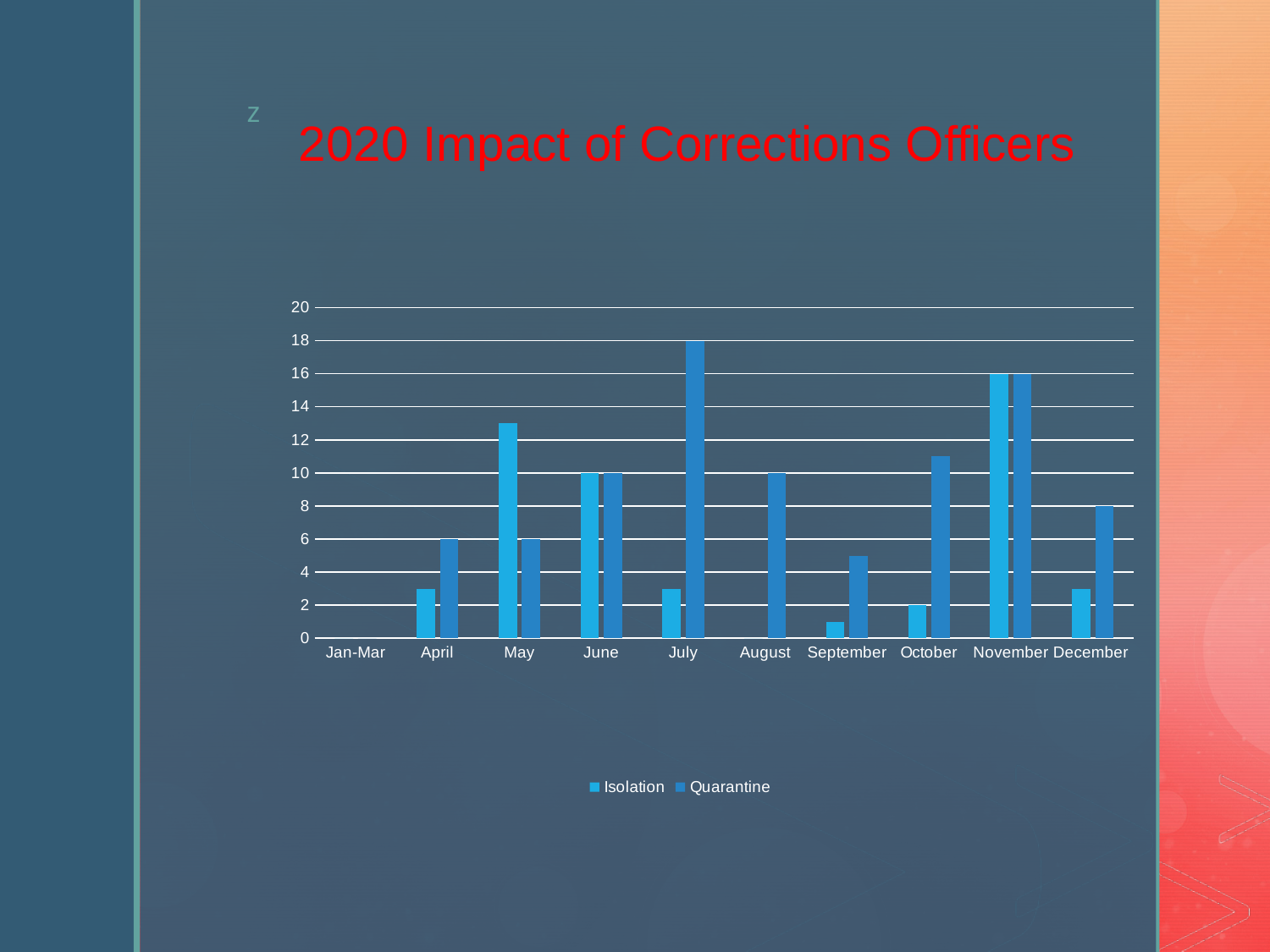
Which is larger in May, Isolation or Quarantine? Isolation What is the Isolation value for November? 16 How many series does the legend list? 2 What type of chart is shown on the slide? bar chart Is the Quarantine value for September greater or less than 6? less Is the Isolation value for May greater or less than 12? greater Which category has the highest Quarantine value? July What is the title of the chart? 2020 Impact of Corrections Officers How many categories are shown on the x axis? 10 Which category has the highest Isolation value? November Which is larger in October, Isolation or Quarantine? Quarantine What is the Quarantine value for June? 10